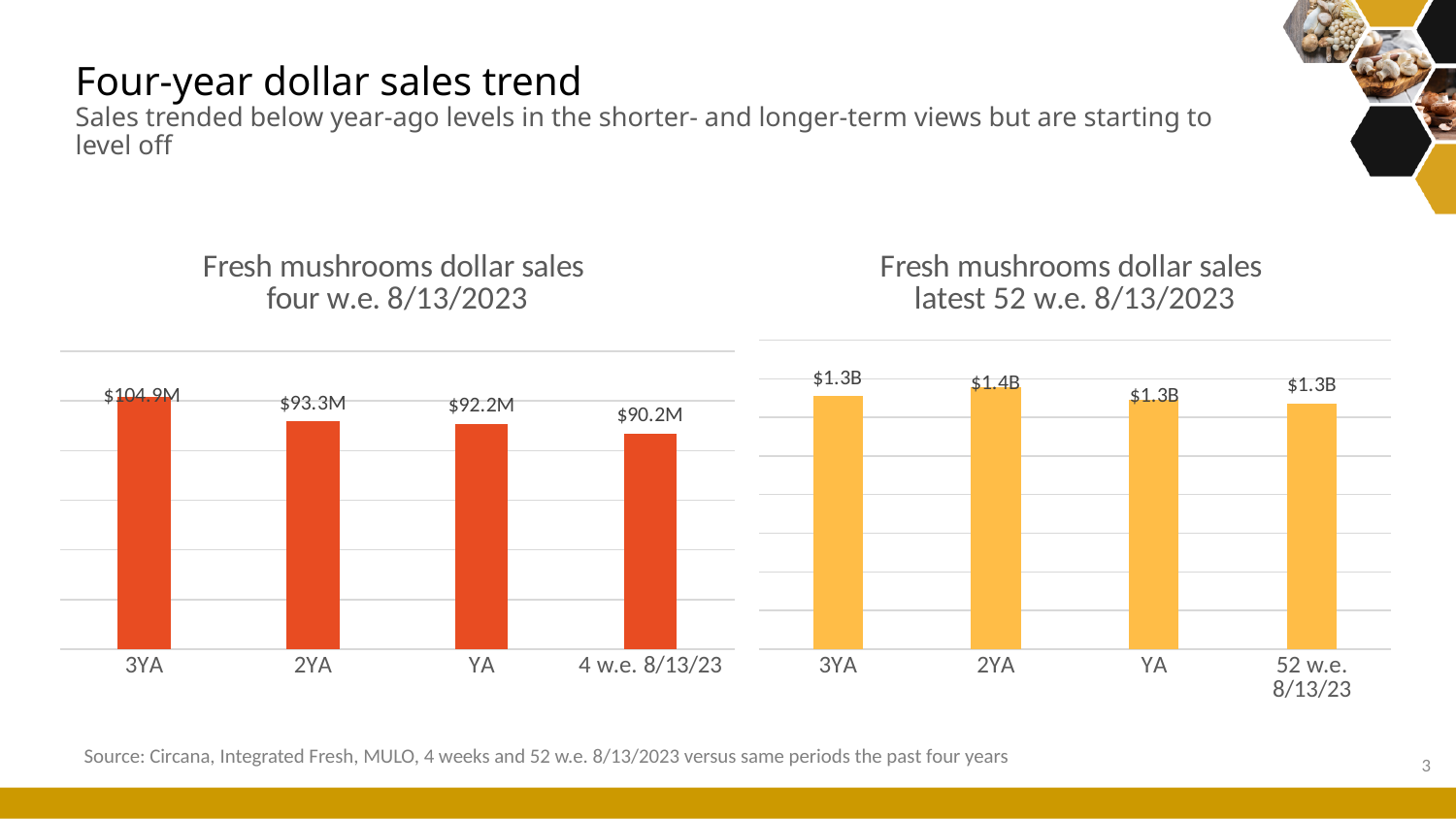
In the chart titled "Fresh mushrooms dollar sales latest 52 w.e. 8/13/2023", what is the value for 52 w.e. 8/13/23? $1.3B In the chart titled "Fresh mushrooms dollar sales four w.e. 8/13/2023", what is the value for 4 w.e. 8/13/23? $90.2M In the chart titled "Fresh mushrooms dollar sales latest 52 w.e. 8/13/2023", which category has the highest value? 2YA In the chart titled "Fresh mushrooms dollar sales four w.e. 8/13/2023", which category has the lowest value? 4 w.e. 8/13/23 In the chart titled "Fresh mushrooms dollar sales four w.e. 8/13/2023", what is the value for 3YA? $104.9M In the chart titled "Fresh mushrooms dollar sales latest 52 w.e. 8/13/2023", what is the value for 2YA? $1.4B In the chart titled "Fresh mushrooms dollar sales four w.e. 8/13/2023", what is the difference between the 3YA value and the 4 w.e. 8/13/23 value? $14.7M In the chart titled "Fresh mushrooms dollar sales four w.e. 8/13/2023", do the values rise or fall from left to right along the x axis? fall What kind of chart is the chart titled "Fresh mushrooms dollar sales four w.e. 8/13/2023"? bar chart In the chart titled "Fresh mushrooms dollar sales four w.e. 8/13/2023", which category has the highest value? 3YA How many categories are shown on the x axis of the chart titled "Fresh mushrooms dollar sales latest 52 w.e. 8/13/2023"? 4 In the chart titled "Fresh mushrooms dollar sales four w.e. 8/13/2023", which is larger, the value for 2YA or the value for YA? 2YA